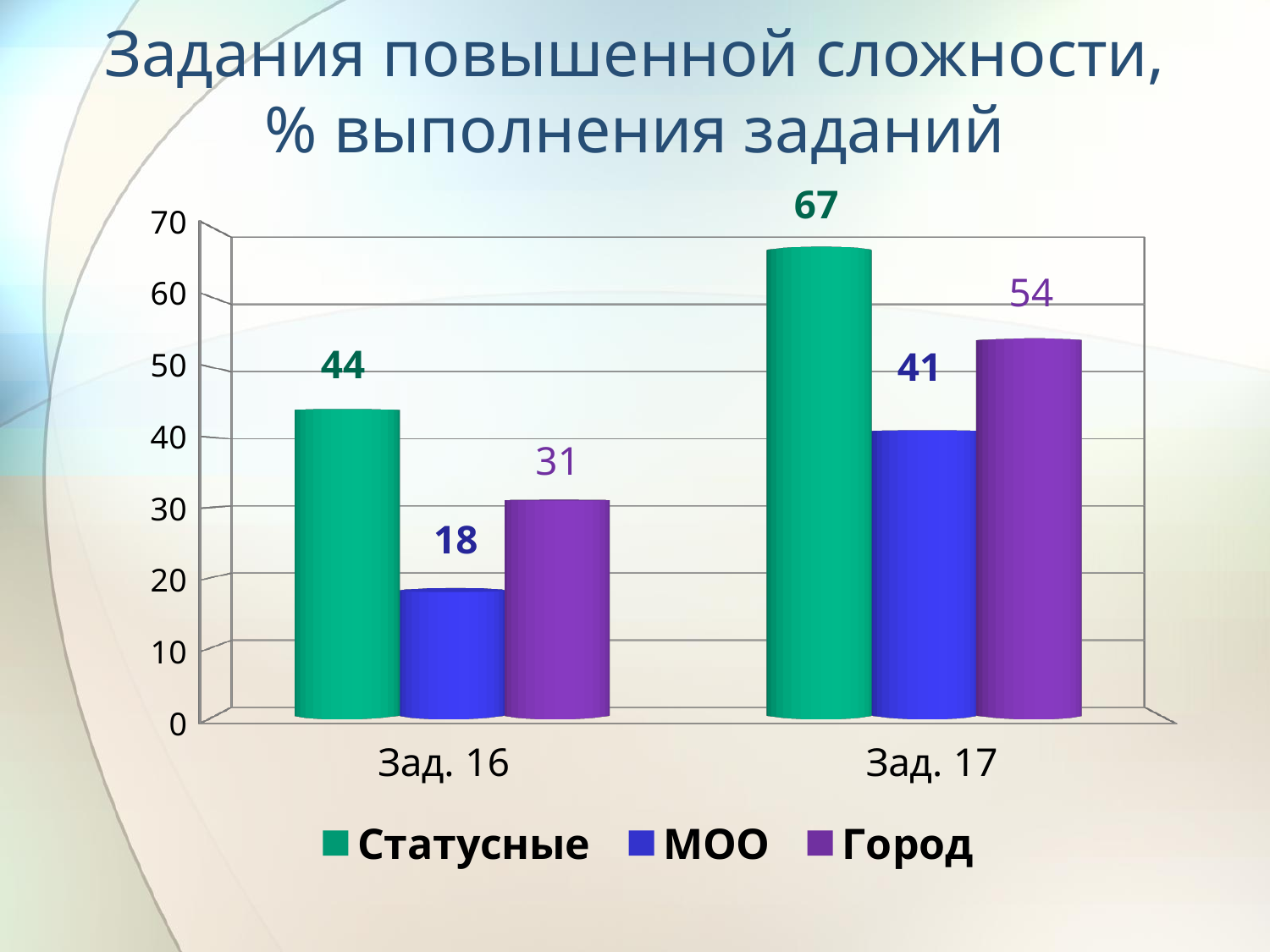
What is the value for Город in Зад. 16? 31 What is the difference between Город and МОО in Зад. 17? 13 What kind of chart is shown on the slide? Bar chart Which series has the highest value in Зад. 17? Статусные What is the value for МОО in Зад. 17? 41 What is the difference between the Статусные values for Зад. 17 and Зад. 16? 23 Does the МОО value rise or fall from Зад. 16 to Зад. 17? Rise How many categories are shown on the x axis? 2 How many series does the legend list? 3 Which series has the lowest value in Зад. 16? МОО What is the value for Статусные in Зад. 16? 44 Which is larger: Город in Зад. 16 or МОО in Зад. 17? МОО in Зад. 17